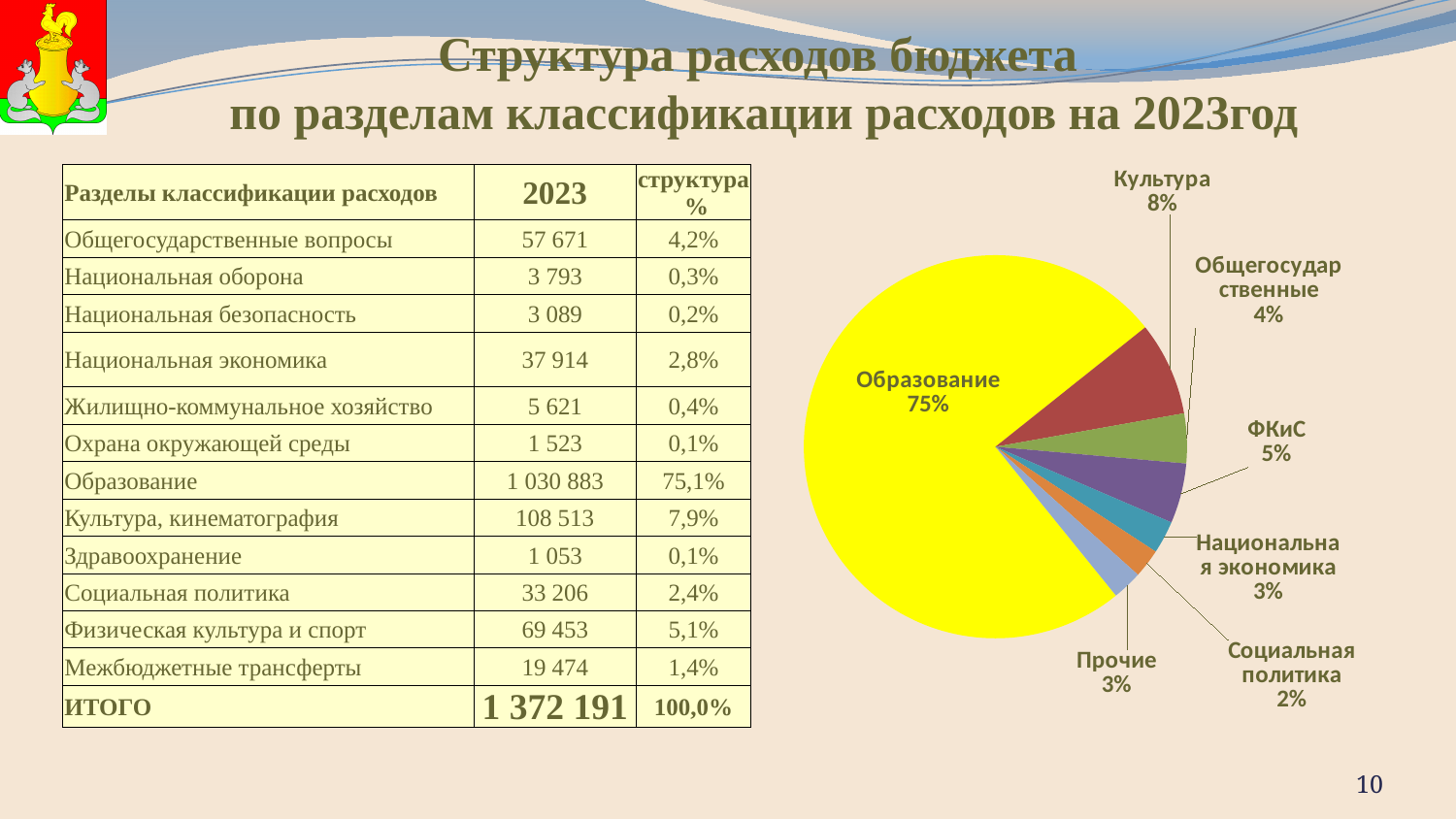
Which is larger in the pie chart, Культура or ФКиС? Культура What kind of chart is shown on the slide? pie chart What colour is the Образование slice in the pie chart? yellow What share of the pie chart does Общегосударственные have? 4% Which slice of the pie chart is the smallest? Социальная политика What share of the pie chart does Образование have? 75% What is the difference in percentage points between Образование and Культура in the pie chart? 67 How many slices does the pie chart have? 7 What share of the pie chart does Культура have? 8% What share of the pie chart does ФКиС have? 5% Which slice of the pie chart is the largest? Образование What share of the pie chart does Социальная политика have? 2%